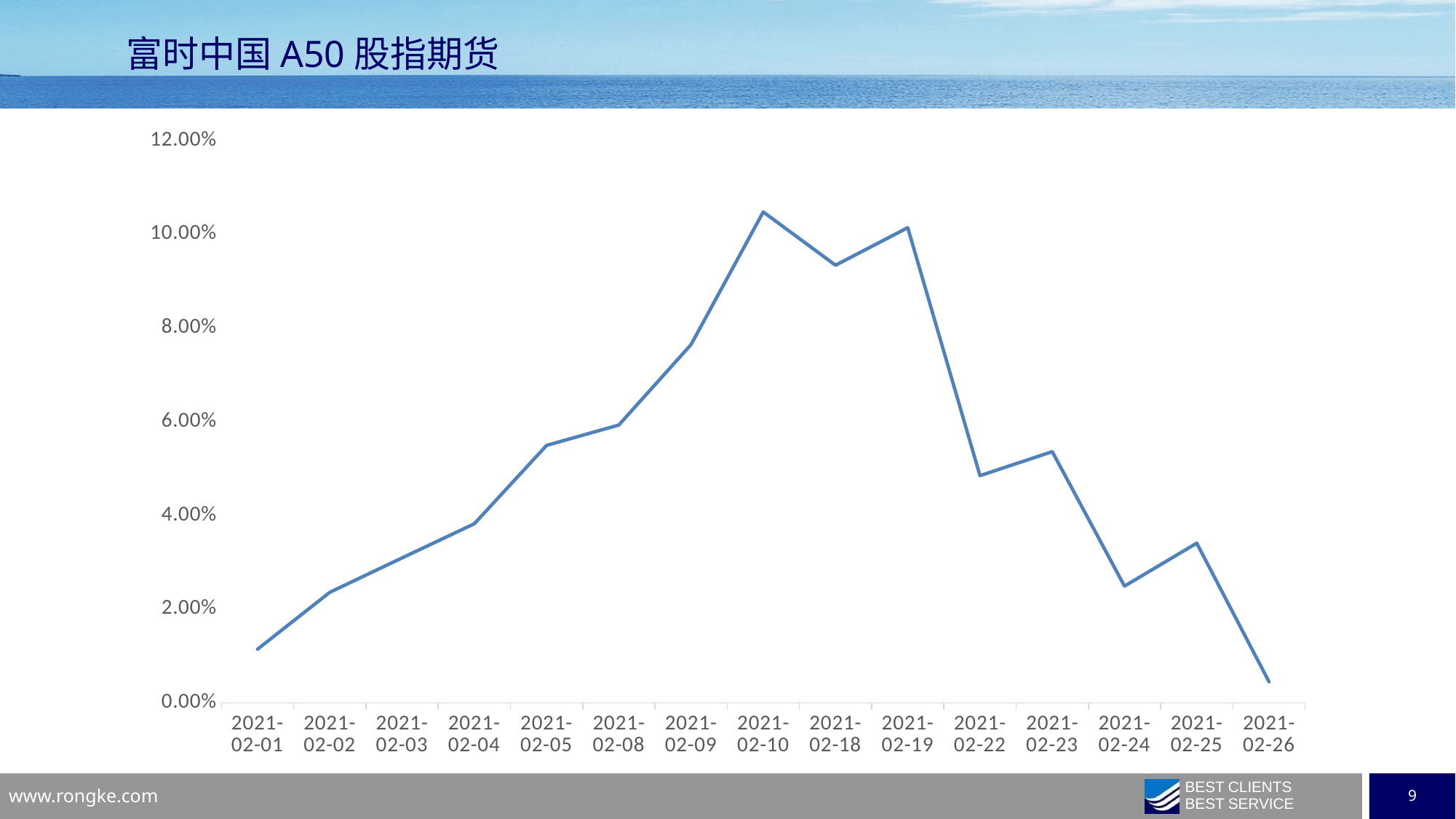
Which date has the higher value, 2021-02-09 or 2021-02-22? 2021-02-09 How many dates are plotted along the x axis? 15 On which date does the line reach its highest value? 2021-02-10 Does the line rise or fall from 2021-02-01 to 2021-02-10? rise Is the value for 2021-02-01 greater or less than 2.00%? less Is the value for 2021-02-10 greater or less than 10.00%? greater On which date does the line reach its lowest value? 2021-02-26 Is the value for 2021-02-18 greater or less than 10.00%? less Does the line generally rise or fall from 2021-02-19 to 2021-02-26? fall What kind of chart is shown on the slide? line chart What is the title of the chart? 富时中国 A50 股指期货